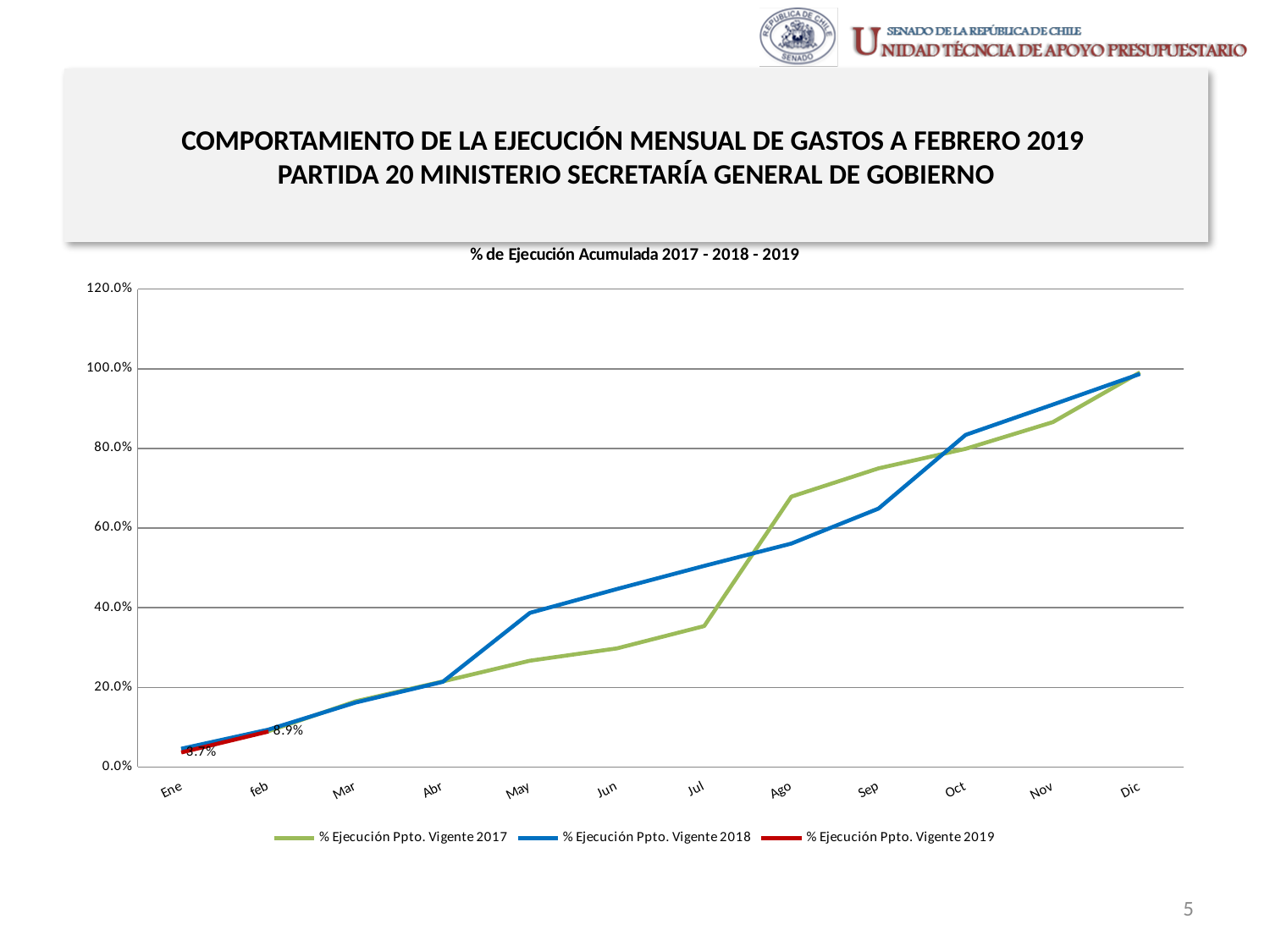
What type of chart is shown on the slide? line chart Is the value for % Ejecución Ppto. Vigente 2017 in Ago greater or less than 60.0%? greater What is the value of % Ejecución Ppto. Vigente 2019 in feb? 8.9% Do the values of % Ejecución Ppto. Vigente 2018 rise or fall from Ene to Dic? rise Is the value for % Ejecución Ppto. Vigente 2018 in Oct greater or less than 80.0%? greater Is the value for % Ejecución Ppto. Vigente 2017 in Jul greater or less than 40.0%? less How many series does the legend list? 3 In Jun, which series has the higher value: % Ejecución Ppto. Vigente 2017 or % Ejecución Ppto. Vigente 2018? % Ejecución Ppto. Vigente 2018 In Ago, which series has the higher value: % Ejecución Ppto. Vigente 2017 or % Ejecución Ppto. Vigente 2018? % Ejecución Ppto. Vigente 2017 How many months are shown along the x axis? 12 In which month does % Ejecución Ppto. Vigente 2017 reach its highest value? Dic What is the title of the chart? % de Ejecución Acumulada 2017 - 2018 - 2019